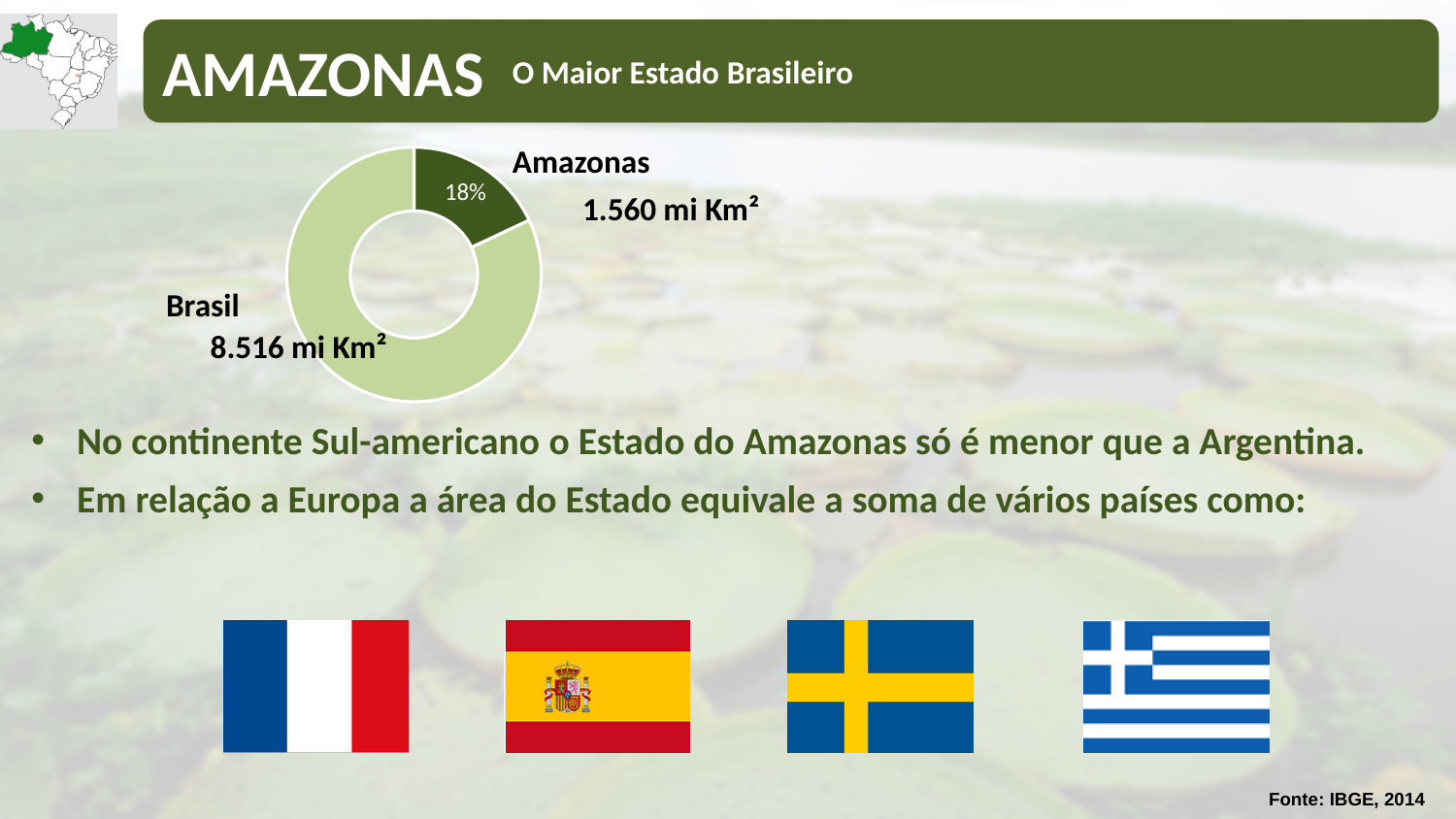
Which slice of the doughnut chart is the largest? Brasil Is the Amazonas share of the doughnut chart greater or less than 25%? less How many slices does the doughnut chart have? 2 What is the difference between the area of Brasil and the area of Amazonas? 6.956 mi Km² What area is given for Amazonas next to the chart? 1.560 mi Km² Which slice of the doughnut chart is the smallest? Amazonas What source is cited at the bottom of the slide? IBGE, 2014 Which has the larger area, Brasil or Amazonas? Brasil What colour is the Amazonas slice of the doughnut chart? Dark green What kind of chart is shown on the slide? Doughnut chart What area is given for Brasil next to the chart? 8.516 mi Km² What percentage is shown on the Amazonas slice of the doughnut chart? 18%